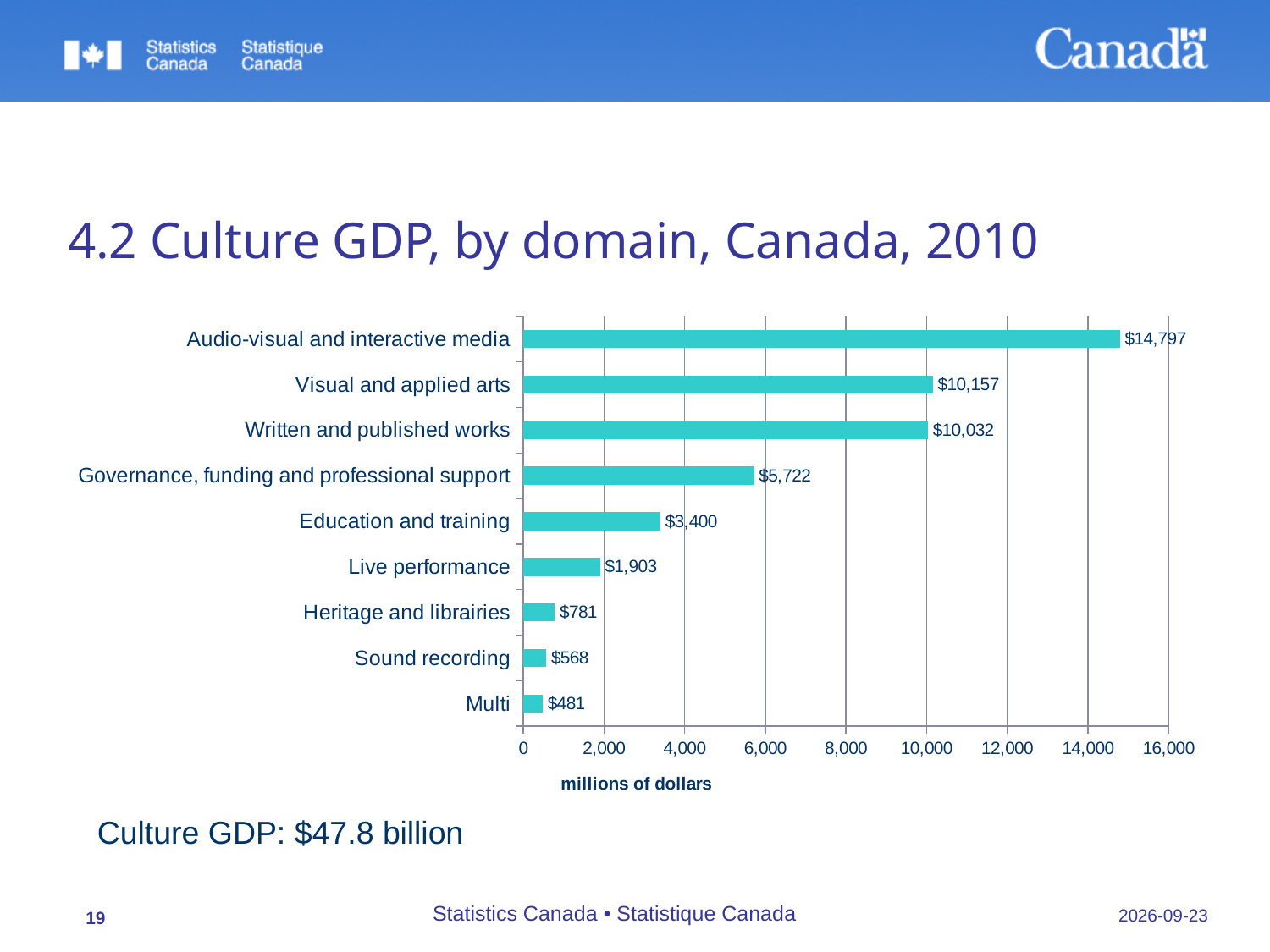
How many domains are shown in the chart? 9 What is the difference between the Culture GDP of Visual and applied arts and Written and published works? $125 What is the Culture GDP value for Sound recording? $568 What unit is shown on the horizontal axis of the chart? millions of dollars What is the Culture GDP value for Education and training? $3,400 What kind of chart is shown on the slide? Bar chart What is the Culture GDP value for Visual and applied arts? $10,157 Which has a larger Culture GDP, Live performance or Heritage and librairies? Live performance Is the value for Governance, funding and professional support greater or less than 6,000? less What is the difference between the Culture GDP of Audio-visual and interactive media and Governance, funding and professional support? $9,075 Which domain has the lowest Culture GDP? Multi Which domain has the highest Culture GDP? Audio-visual and interactive media